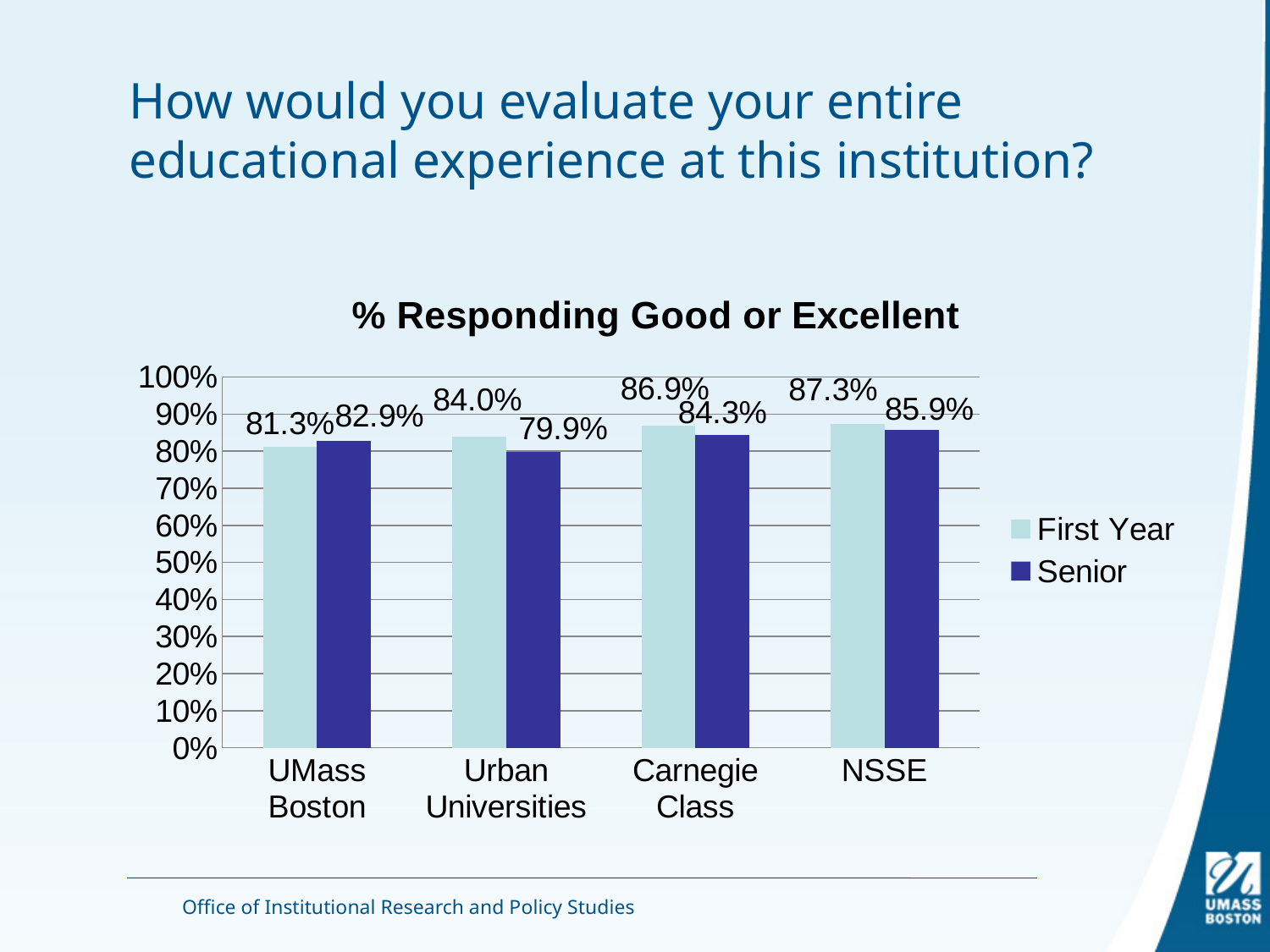
What is the difference between the First Year and Senior values for Urban Universities? 4.1% How many series does the legend list? 2 What kind of chart is shown? Bar chart Which category has the lowest Senior value? Urban Universities What is the Senior value for Urban Universities? 79.9% What is the Senior value for Carnegie Class? 84.3% What is the title of the chart? % Responding Good or Excellent What is the First Year value for UMass Boston? 81.3% Which is larger for UMass Boston, the First Year value or the Senior value? Senior How many categories are shown on the x axis? 4 What is the First Year value for NSSE? 87.3% Which category has the highest First Year value? NSSE